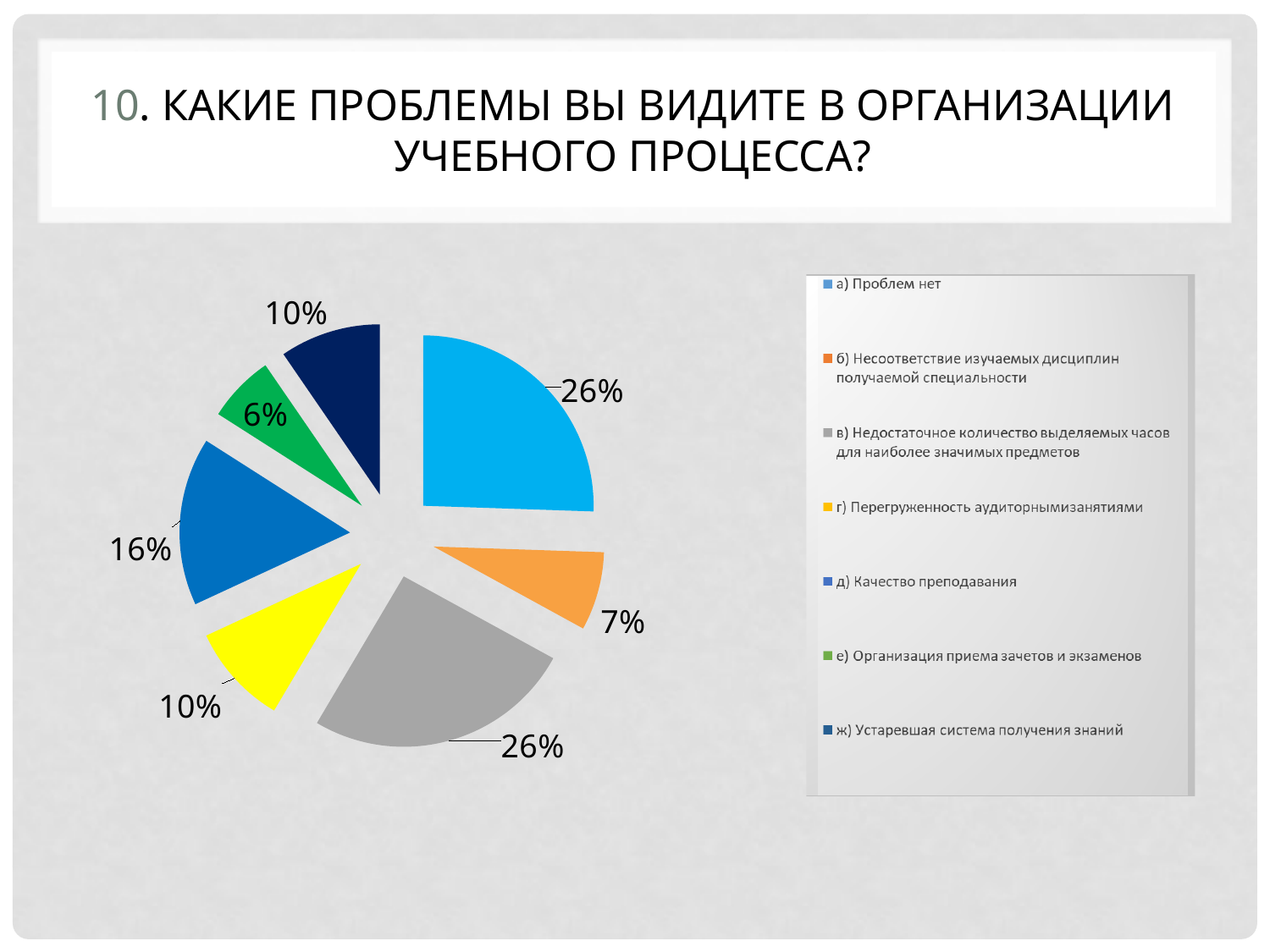
How many categories does the pie chart have? 7 What is the value for "г) Перегруженность аудиторными занятиями"? 10% What kind of chart is shown on the slide? pie chart What is the value for "д) Качество преподавания"? 16% What colour is the slice for "ж) Устаревшая система получения знаний"? dark blue What is the difference between the values for "д) Качество преподавания" and "б) Несоответствие изучаемых дисциплин получаемой специальности"? 9% What is the value for "е) Организация приема зачетов и экзаменов"? 6% What share of the pie does "а) Проблем нет" have? 26% What is the value for "б) Несоответствие изучаемых дисциплин получаемой специальности"? 7% Which category has the smallest slice of the pie? е) Организация приема зачетов и экзаменов What is the value for "в) Недостаточное количество выделяемых часов для наиболее значимых предметов"? 26% Which is larger: the value for "д) Качество преподавания" or the value for "ж) Устаревшая система получения знаний"? д) Качество преподавания